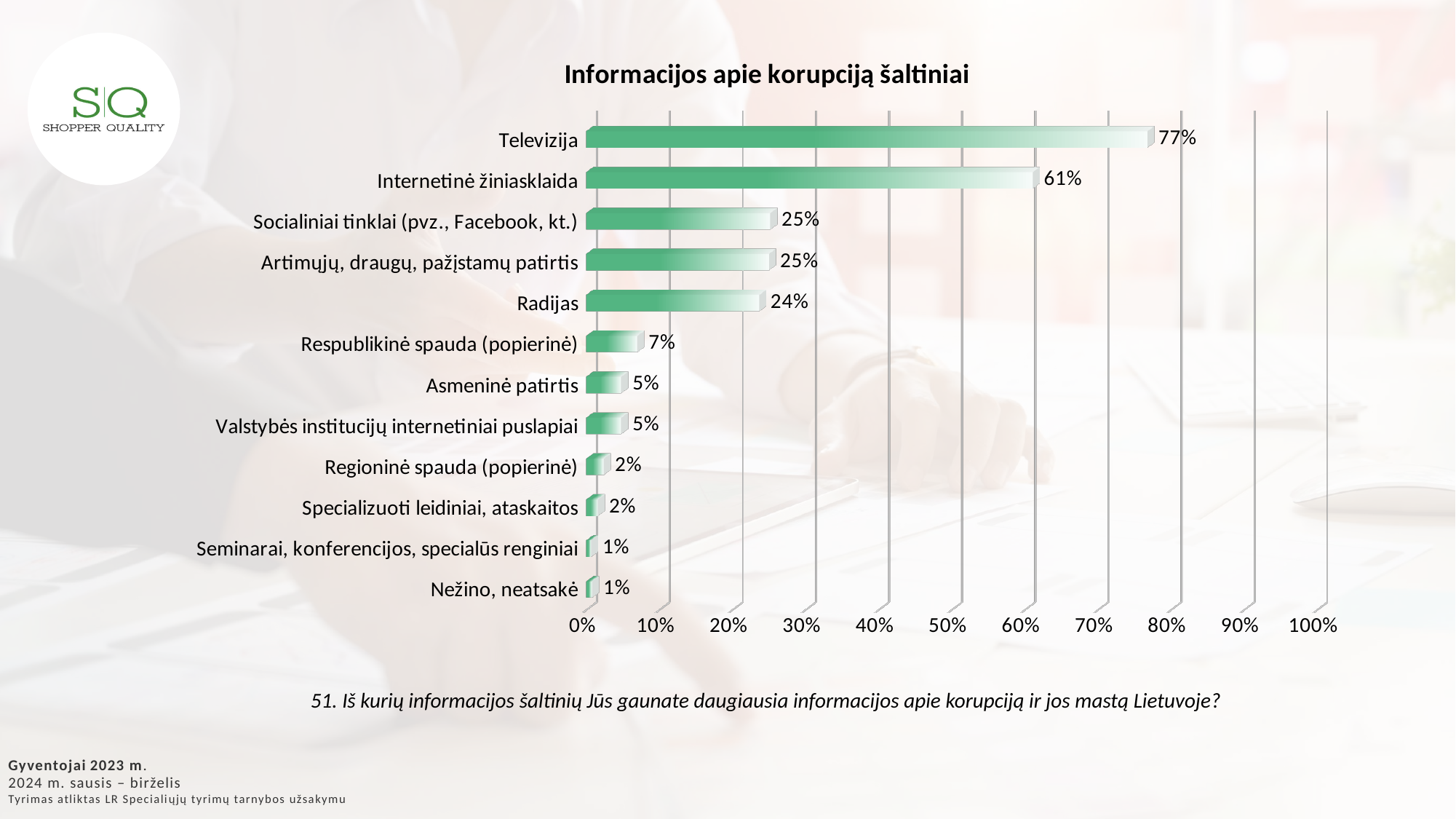
What kind of chart is shown on the slide? bar chart Is the value for Internetinė žiniasklaida greater or less than 50%? greater Which is larger, the value for Radijas or the value for Asmeninė patirtis? Radijas What is the value for Valstybės institucijų internetiniai puslapiai? 5% What is the value for Respublikinė spauda (popierinė)? 7% What is the difference between the values for Televizija and Internetinė žiniasklaida? 16% Which category has the highest value? Televizija How many categories are shown in the chart? 12 What is the title of the chart? Informacijos apie korupciją šaltiniai What is the value for Televizija? 77% What is the value for Radijas? 24% What is the value for Internetinė žiniasklaida? 61%